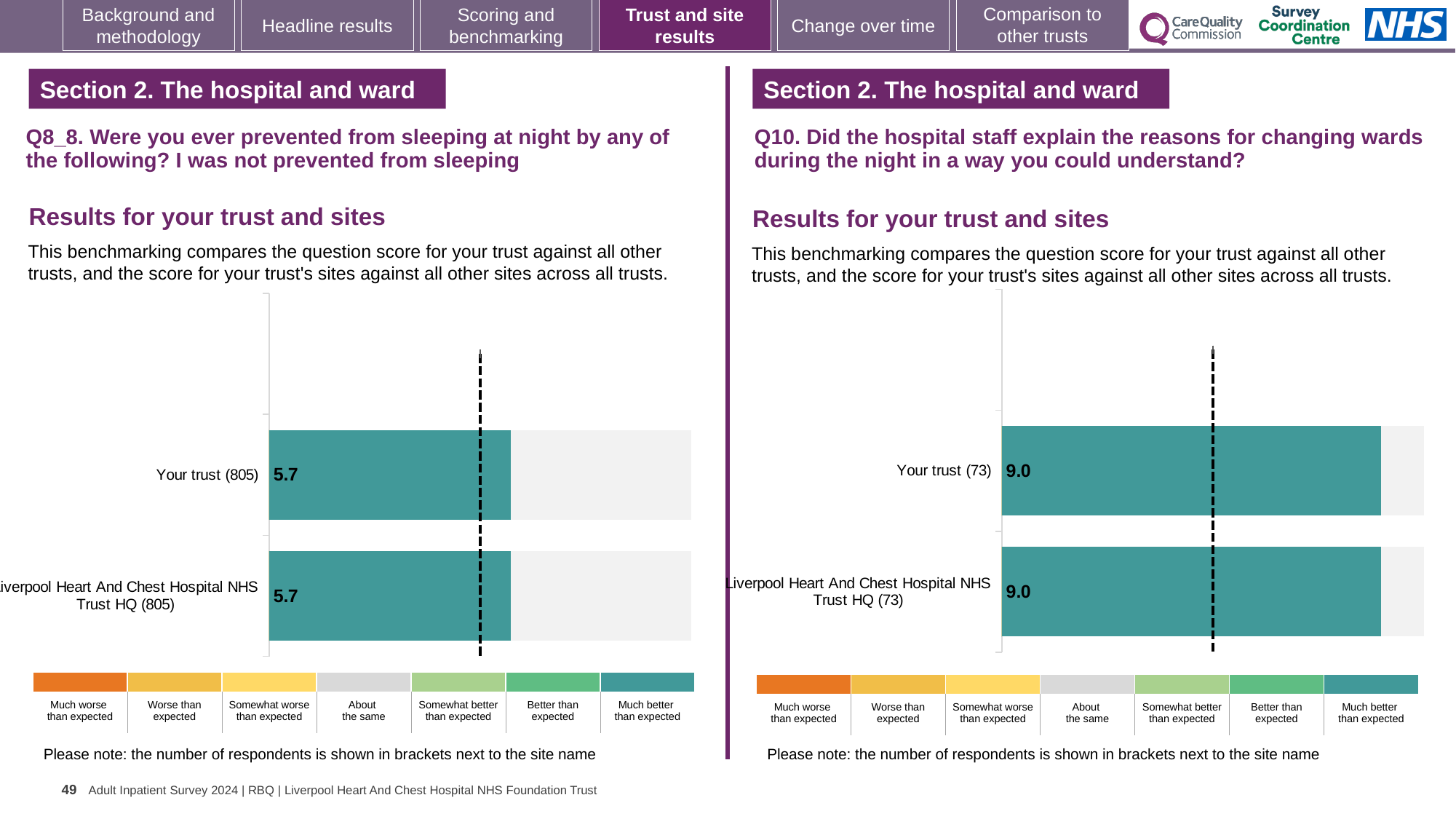
On the left chart (Q8_8), what is the score for Liverpool Heart And Chest Hospital NHS Trust HQ (805)? 5.7 How many respondents are shown in brackets for Your trust on the left chart (Q8_8)? 805 How many bars are plotted on the left chart (Q8_8)? 2 On the right chart (Q10), what is the difference between the score for Your trust and the score for Liverpool Heart And Chest Hospital NHS Trust HQ? 0.0 On the left chart (Q8_8), what is the score for Your trust (805)? 5.7 What kind of chart is used on the left (Q8_8)? Bar chart How many bars are plotted on the right chart (Q10)? 2 On the right chart (Q10), what is the score for Your trust (73)? 9.0 Is the score for Your trust on the right chart (Q10) larger or smaller than the score for Your trust on the left chart (Q8_8)? Larger On the left chart (Q8_8), what is the difference between the score for Your trust and the score for Liverpool Heart And Chest Hospital NHS Trust HQ? 0.0 On the right chart (Q10), what is the score for Liverpool Heart And Chest Hospital NHS Trust HQ (73)? 9.0 How many respondents are shown in brackets for Your trust on the right chart (Q10)? 73